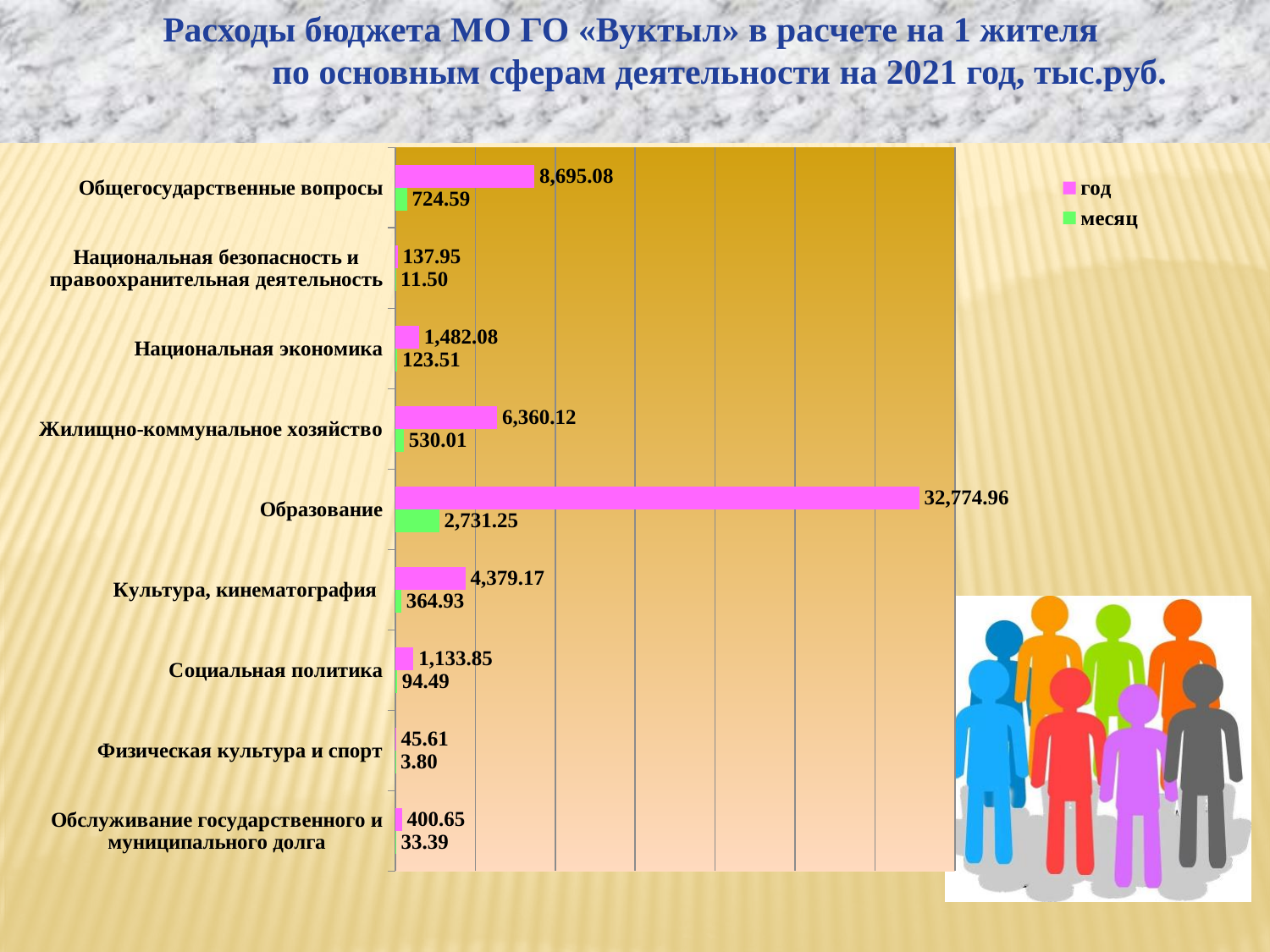
What is the value for Национальная экономика in the год series? 1,482.08 How many series does the legend list? 2 What kind of chart is shown on the slide? Bar chart Which category has the lowest value in the год series? Физическая культура и спорт What is the value for Физическая культура и спорт in the месяц series? 3.80 Which category has the highest value in the год series? Образование What is the value for Жилищно-коммунальное хозяйство in the месяц series? 530.01 What is the difference between the год and месяц values for Общегосударственные вопросы? 7,970.49 How many categories are shown on the chart? 9 What is the value for Образование in the год series? 32,774.96 What are the two series named in the legend? год and месяц Which has the larger год value: Культура, кинематография or Жилищно-коммунальное хозяйство? Жилищно-коммунальное хозяйство